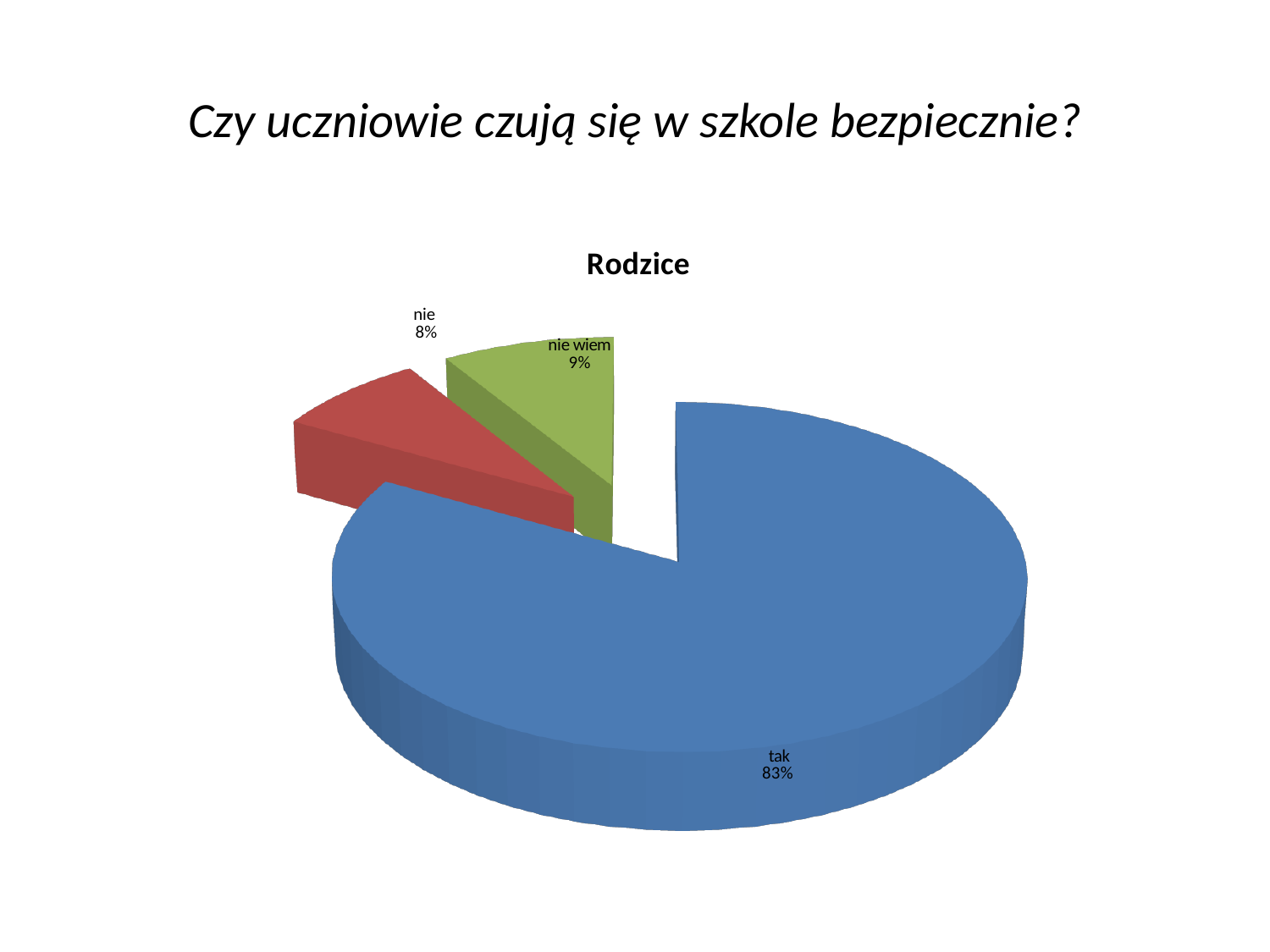
Which is larger, the "tak" slice or the "nie" slice? tak What is the difference in percentage points between the "nie wiem" slice and the "nie" slice? 1 What share of the pie does the "nie wiem" slice represent? 9% Which category has the smallest slice of the pie? nie Which category has the largest slice of the pie? tak How many slices does the pie chart have? 3 What share of the pie does the "nie" slice represent? 8% What colour is the "tak" slice? blue What kind of chart is shown on the slide? pie chart What is the title of the chart? Rodzice What share of the pie does the "tak" slice represent? 83% What is the difference in percentage points between the "tak" slice and the "nie wiem" slice? 74